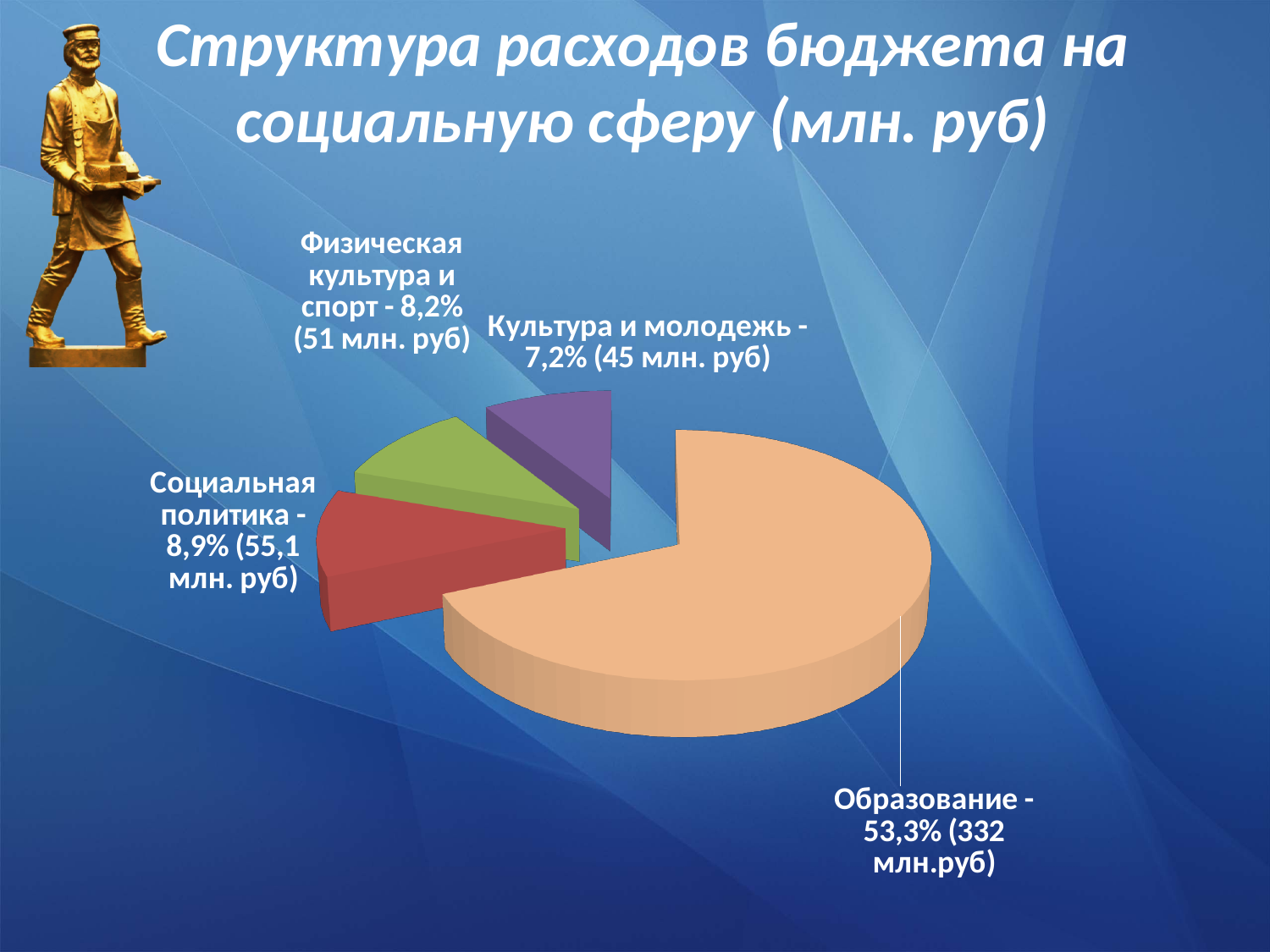
What percentage share is shown for Физическая культура и спорт? 8,2% What is the difference in млн. руб between Образование and Культура и молодежь? 287 Which category has the largest slice of the pie? Образование Which is larger, the value for Социальная политика or the value for Физическая культура и спорт? Социальная политика Which category has the smallest slice of the pie? Культура и молодежь What is the title of the chart on the slide? Структура расходов бюджета на социальную сферу (млн. руб) How many slices does the pie chart have? 4 What kind of chart is shown on the slide? pie chart What share of the pie does Образование account for? 53,3% What is the value in млн. руб for Образование? 332 What is the value in млн. руб for Социальная политика? 55,1 What is the value in млн. руб for Культура и молодежь? 45